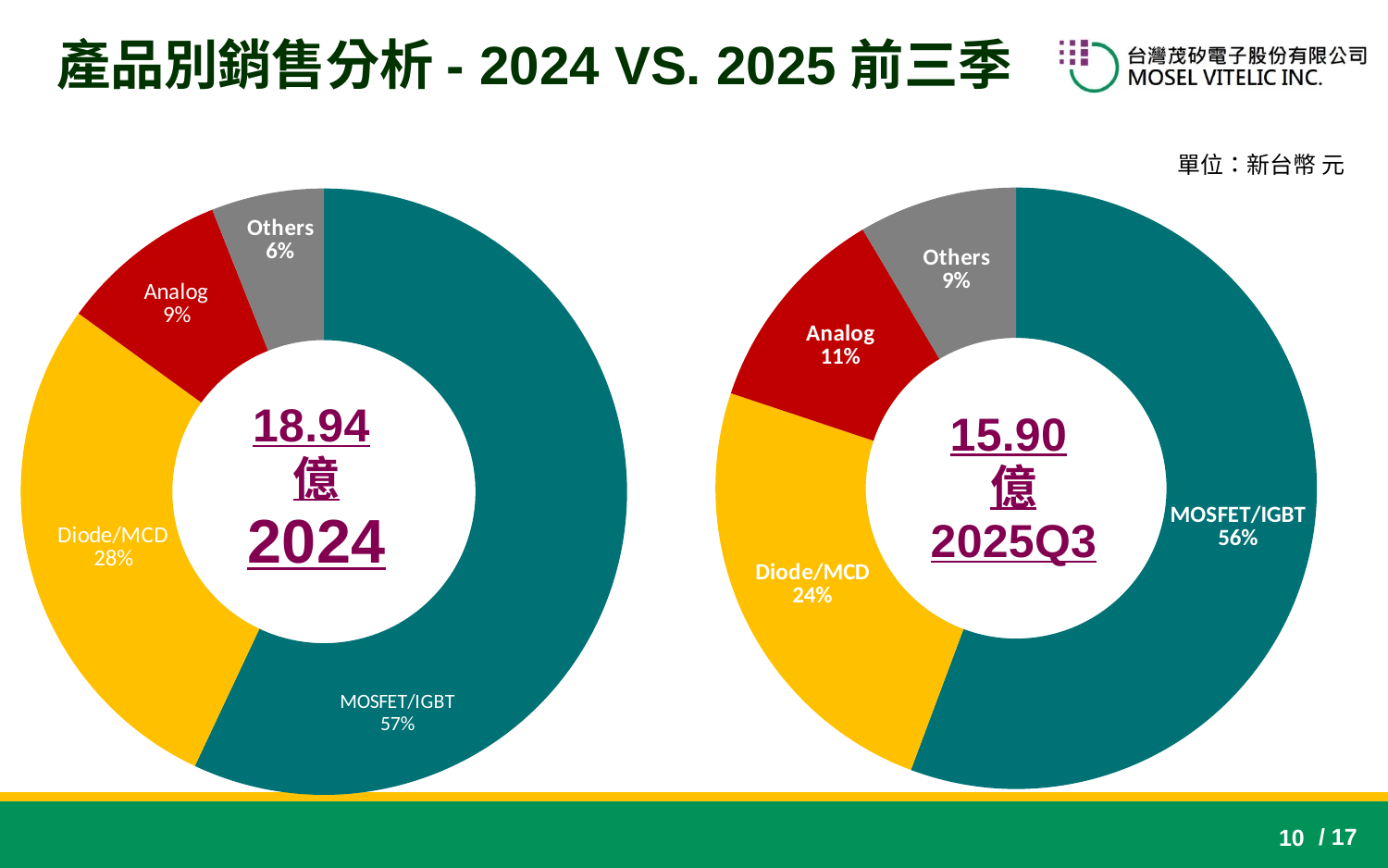
In the right (2025Q3) chart, which is larger, Analog or Others? Analog What total amount is shown in the centre of the right (2025Q3) chart? 15.90 億 What total amount is shown in the centre of the left (2024) chart? 18.94 億 In the left (2024) chart, which category has the largest share? MOSFET/IGBT In the right (2025Q3) chart, which category has the smallest share? Others What kind of chart is the right (2025Q3) chart? Pie chart (donut) In the left (2024) chart, what is the value for Analog? 9% In the right (2025Q3) chart, what is the value for Others? 9% In the right (2025Q3) chart, what share does Diode/MCD have? 24% In the left (2024) chart, what is the difference between the Diode/MCD share and the Analog share? 19% How many categories does the left (2024) chart show? 4 In the left (2024) chart, what share does MOSFET/IGBT have? 57%